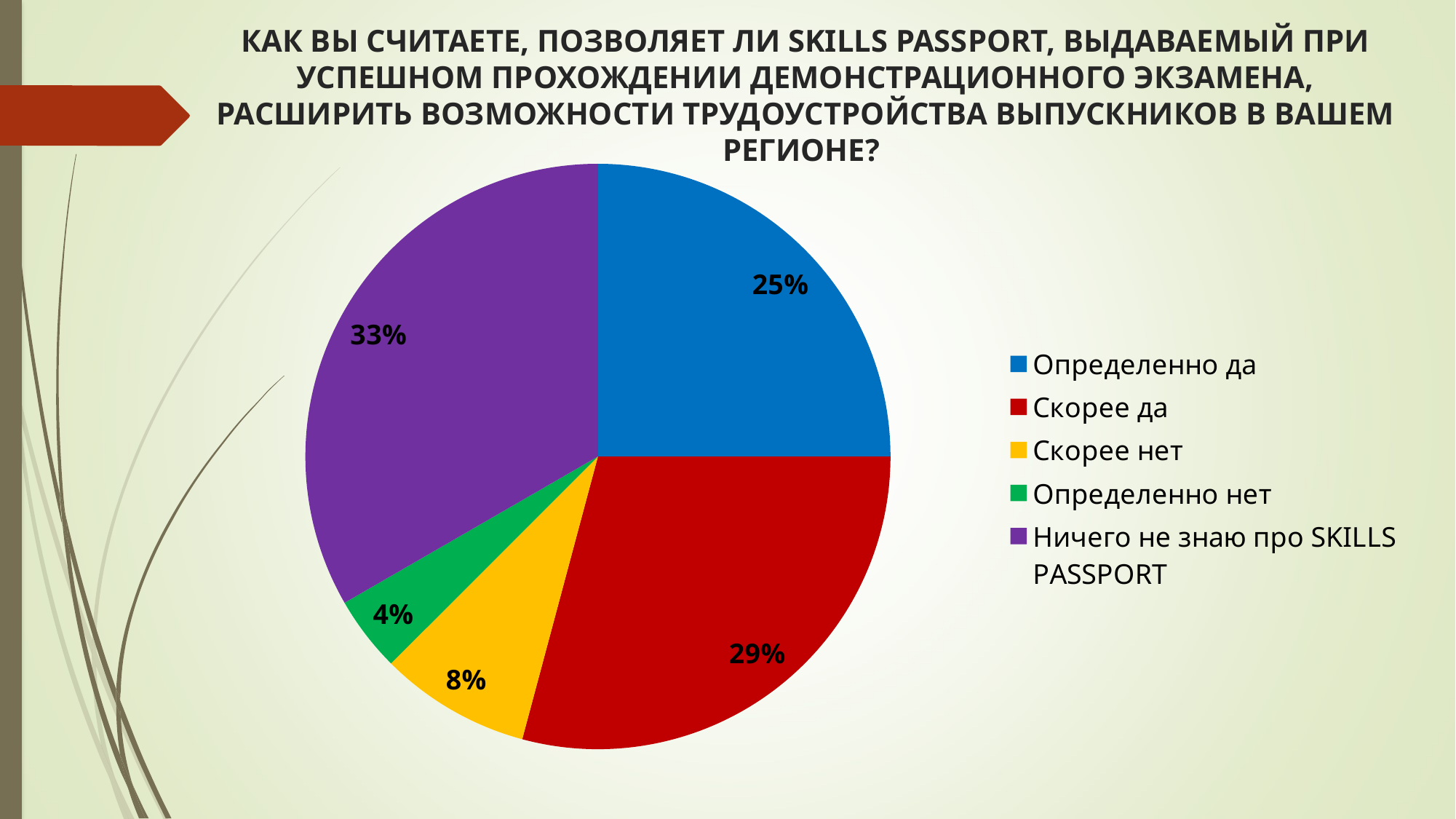
What kind of chart is shown on the slide? pie chart What share of respondents answered "Скорее нет"? 8% What is the difference in percentage points between "Скорее да" and "Определенно да"? 4 What share of respondents answered "Определенно нет"? 4% What share of respondents answered "Ничего не знаю про SKILLS PASSPORT"? 33% How many answer options (slices) does the pie chart have? 5 Which answer option has the smallest share of the pie? Определенно нет Which is larger: the share for "Скорее нет" or the share for "Определенно нет"? Скорее нет Which answer option has the largest share of the pie? Ничего не знаю про SKILLS PASSPORT What share of respondents answered "Скорее да"? 29% Which colour represents "Скорее да" in the legend? red What share of respondents answered "Определенно да"? 25%